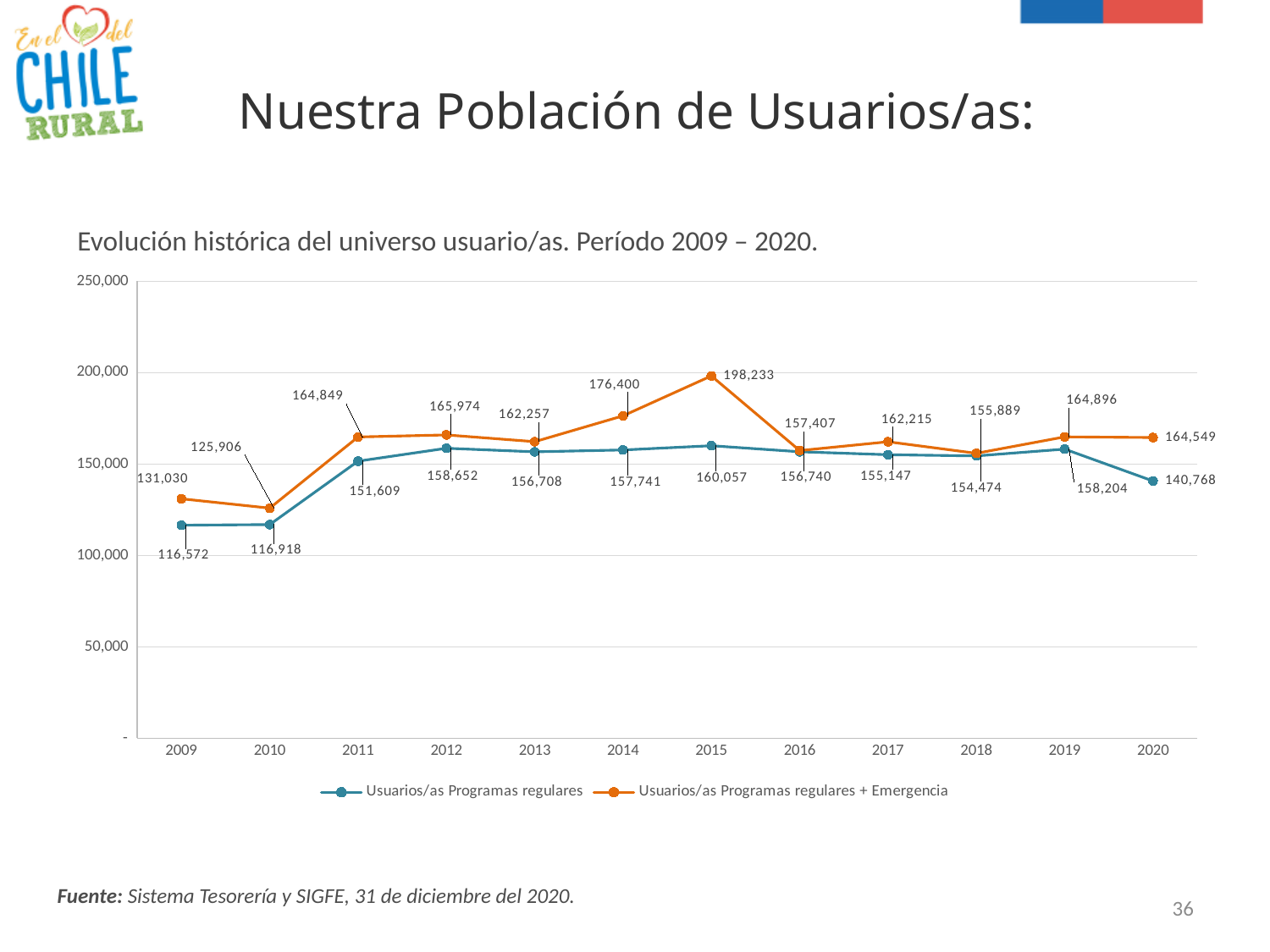
What is the title shown above the chart? Evolución histórica del universo usuario/as. Período 2009 – 2020. In which year does the Usuarios/as Programas regulares + Emergencia series reach its highest value? 2015 In which year is the Usuarios/as Programas regulares series at its lowest value? 2009 Does the Usuarios/as Programas regulares series rise or fall from 2019 to 2020? Fall What is the value for Usuarios/as Programas regulares in 2009? 116,572 What is the value for Usuarios/as Programas regulares + Emergencia in 2015? 198,233 How many years are plotted along the x axis? 12 What is the value for Usuarios/as Programas regulares in 2020? 140,768 What is the difference between the two series in 2015? 38,176 What type of chart is shown on the slide? Line chart Which series has the larger value in 2014? Usuarios/as Programas regulares + Emergencia How many series does the legend list? 2